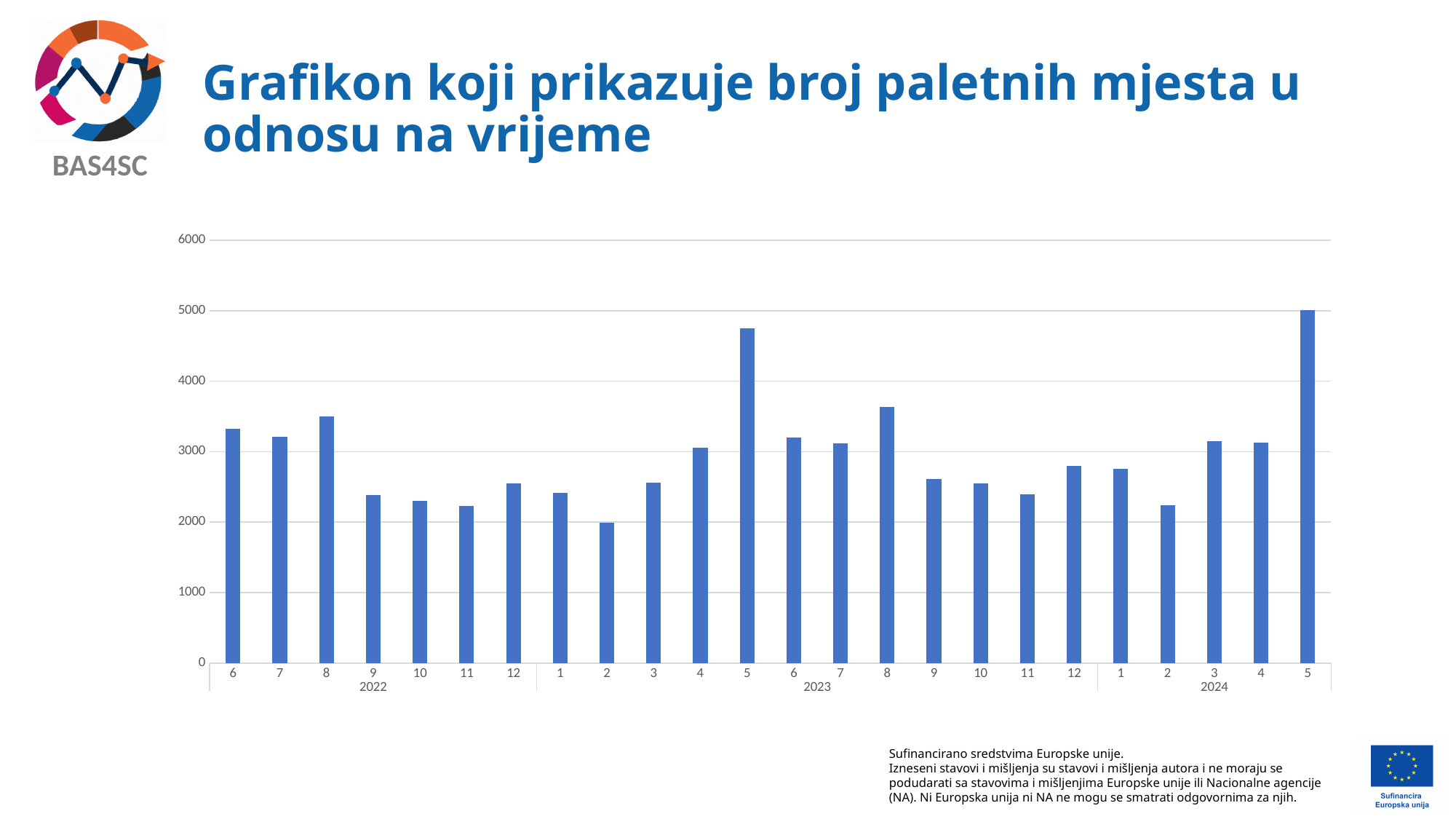
Is the value for month 8 of 2022 greater or less than 3000? greater Is the value for month 5 of 2023 greater or less than 4000? greater Is the value for month 2 of 2024 greater or less than 3000? less Which is larger, the value for month 5 of 2023 or the value for month 8 of 2023? month 5 of 2023 What kind of chart is shown on the slide? bar chart Which is larger, the value for month 8 of 2022 or the value for month 9 of 2022? month 8 of 2022 Which years are labelled on the x axis of the chart? 2022, 2023, 2024 Which month has the lowest number of pallet places in the chart? 2 (2023) Do the values rise or fall from month 2 to month 5 of 2023? rise Which month has the highest number of pallet places in the chart? 5 (2024) How many bars (months) are plotted in the chart? 24